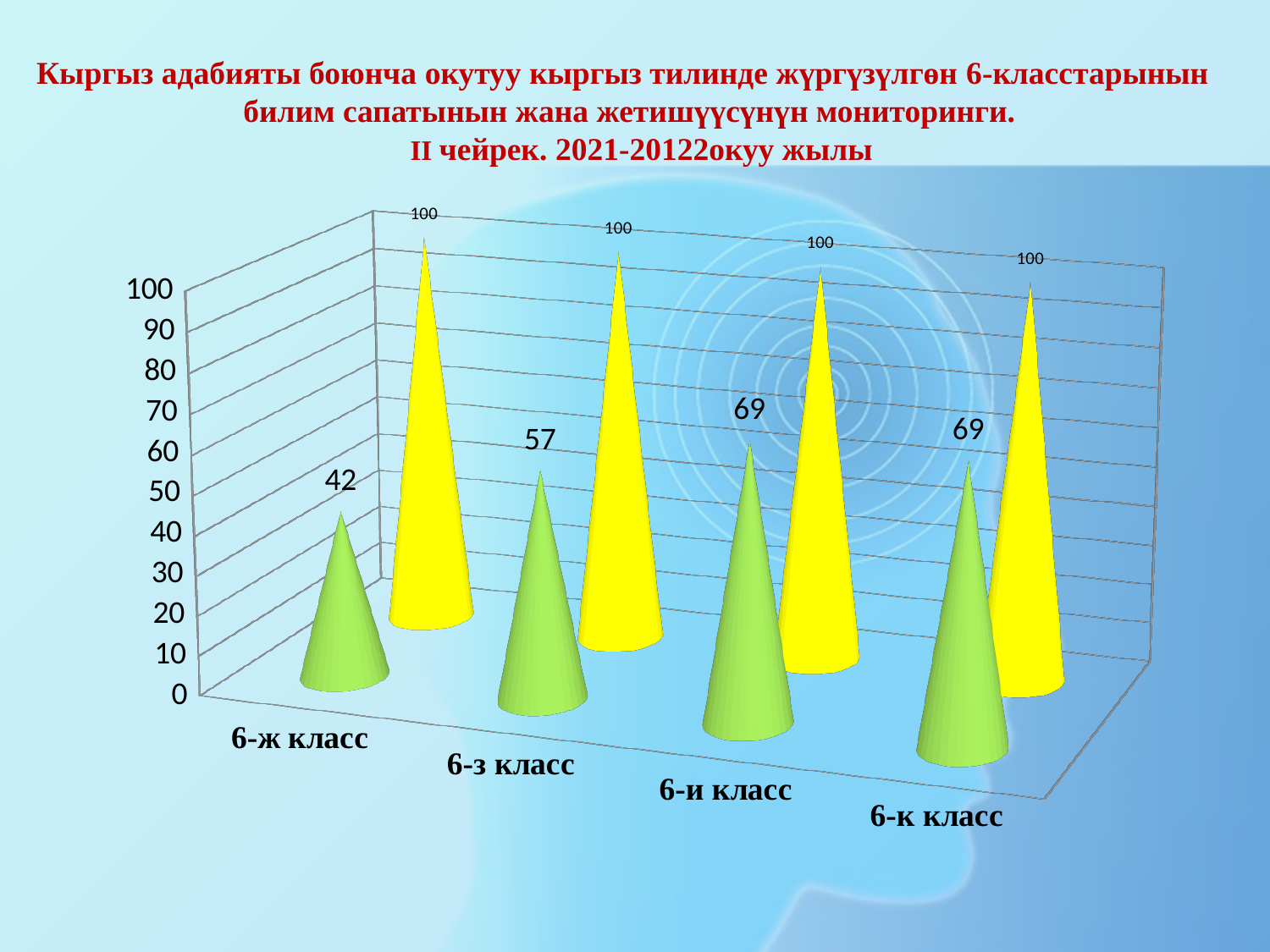
Which class has the lowest green cone value? 6-ж класс Do the green cone values rise or fall from 6-ж класс to 6-и класс? rise What is the highest value shown on the vertical axis? 100 What is the value of the green cone for 6-и класс? 69 What is the difference between the yellow and green values for 6-и класс? 31 What kind of chart is shown on the slide? bar chart What is the difference between the green values for 6-з класс and 6-ж класс? 15 How many classes are shown on the x axis? 4 What is the value of the green cone for 6-з класс? 57 What is the value of the yellow cone for 6-к класс? 100 What is the value of the green cone for 6-ж класс? 42 Which is larger, the green value for 6-з класс or the green value for 6-к класс? 6-к класс